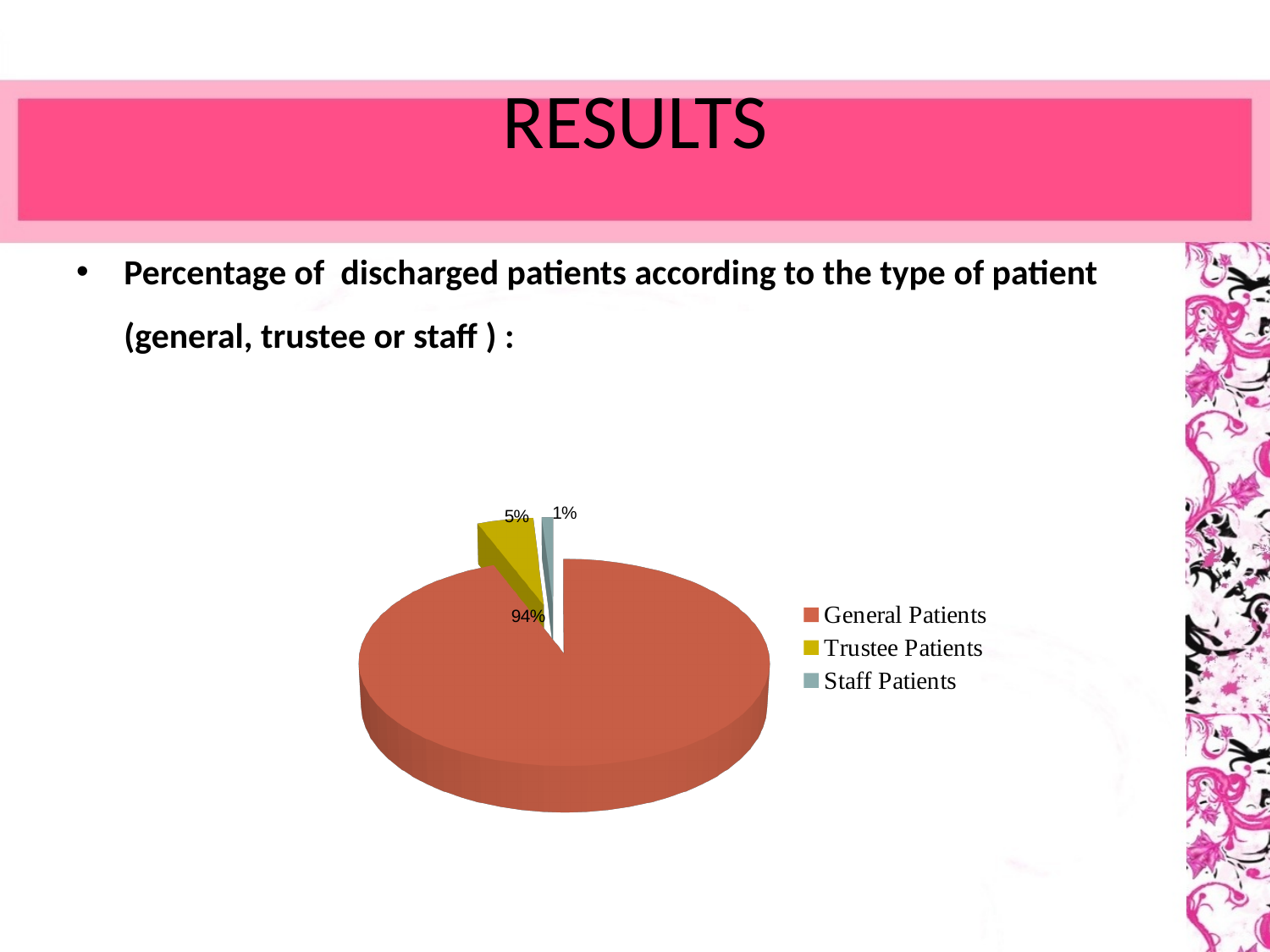
Which is larger, the share for Trustee Patients or the share for Staff Patients? Trustee Patients Which patient type has the smallest share of the pie? Staff Patients What percentage of discharged patients are Trustee Patients? 5% What colour is the slice for Trustee Patients? yellow What kind of chart is shown on the slide? pie chart What is the difference in percentage points between Trustee Patients and Staff Patients? 4 How many entries does the legend list? 3 What is the difference in percentage points between General Patients and Trustee Patients? 89 Which patient type has the largest share of the pie? General Patients How many categories does the pie chart show? 3 What percentage of discharged patients are General Patients? 94% What percentage of discharged patients are Staff Patients? 1%